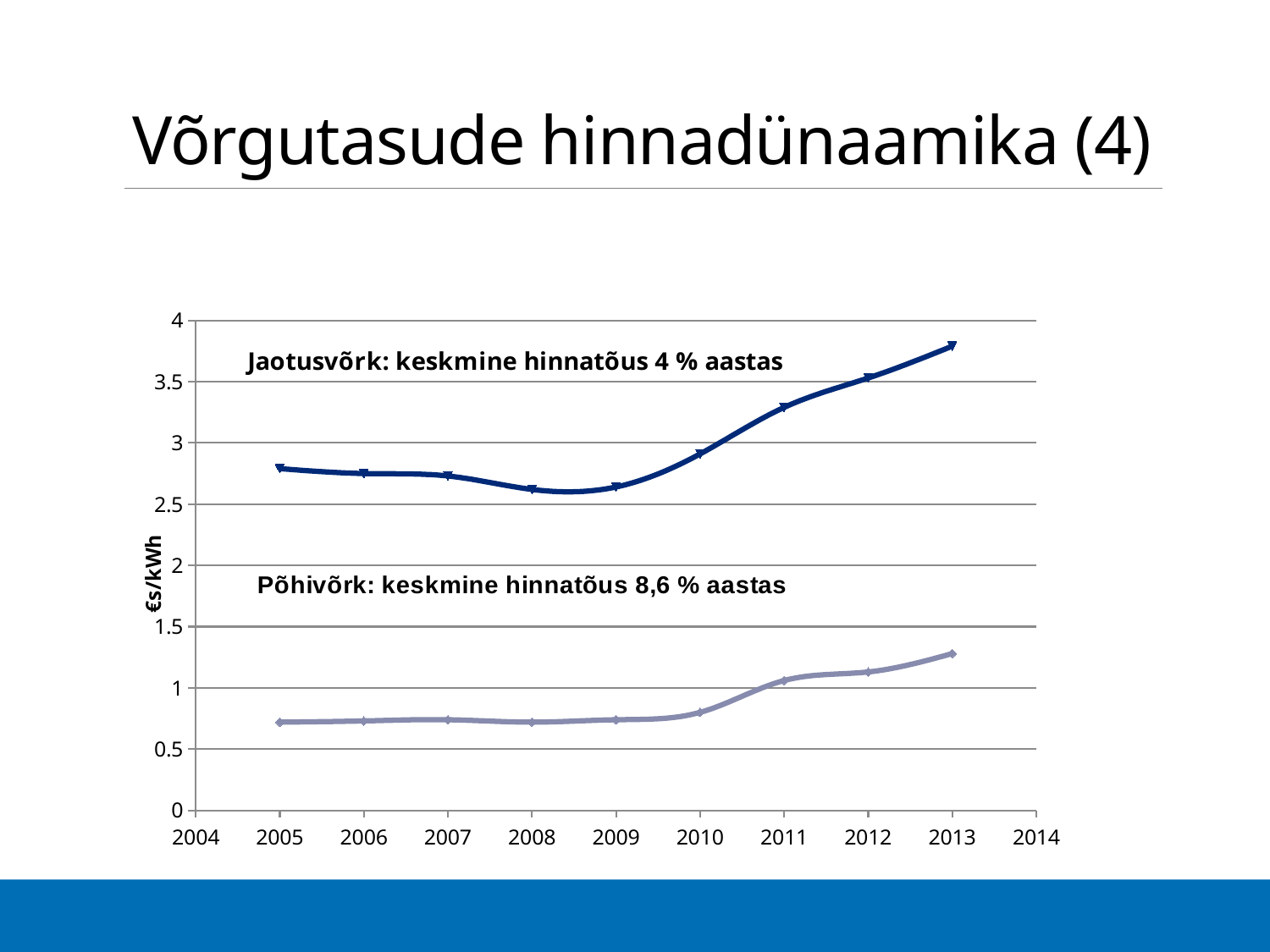
Is the Põhivõrk value for 2013 greater or less than 1? greater Which line is higher in 2010, Jaotusvõrk or Põhivõrk? Jaotusvõrk What kind of chart is shown on the slide? line chart According to the annotation on the chart, what is the average annual price increase for Jaotusvõrk? 4 % aastas Does the Põhivõrk line rise or fall between 2010 and 2013? rise Is the Jaotusvõrk value for 2008 greater or less than 3? less Is the Põhivõrk value for 2005 greater or less than 1? less What is the label on the vertical axis of the chart? €s/kWh How many data points does each line on the chart have? 9 In which year does the Jaotusvõrk line reach its lowest value? 2008 In which year does the Jaotusvõrk line reach its highest value? 2013